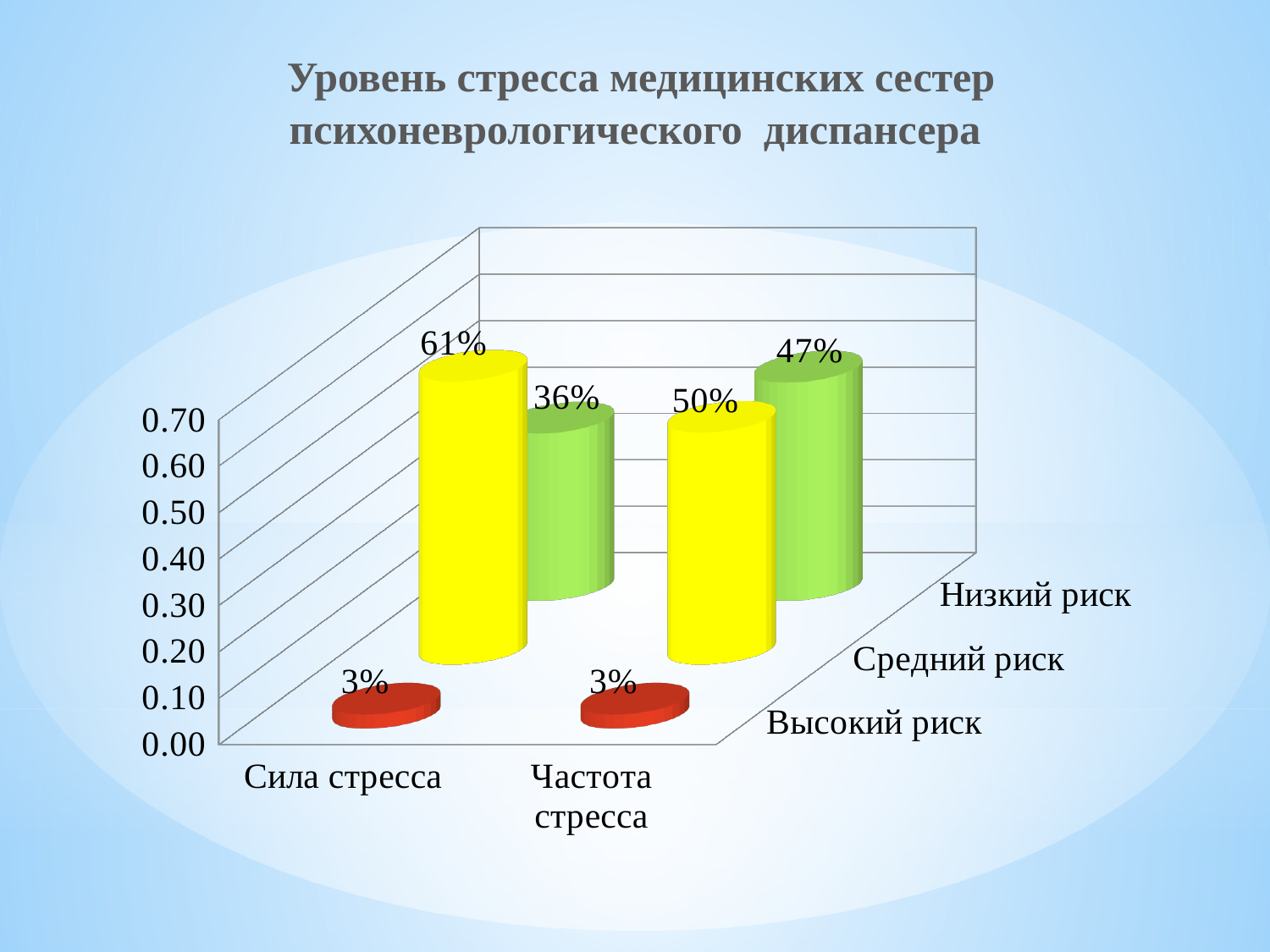
How many categories are shown on the x axis? 2 What is the value for Средний риск in the Сила стресса category? 61% Which is larger: Средний риск for Сила стресса or Средний риск for Частота стресса? Средний риск for Сила стресса What is the difference between Средний риск and Низкий риск in the Сила стресса category? 25% What is the value for Высокий риск in the Сила стресса category? 3% What kind of chart is shown on the slide? Bar chart How many series (risk levels) are plotted in the chart? 3 What is the title of the chart? Уровень стресса медицинских сестер психоневрологического диспансера Which risk level has the highest value in the Сила стресса category? Средний риск What is the value for Низкий риск in the Частота стресса category? 47% Which risk level has the lowest value in the Частота стресса category? Высокий риск What is the value for Средний риск in the Частота стресса category? 50%